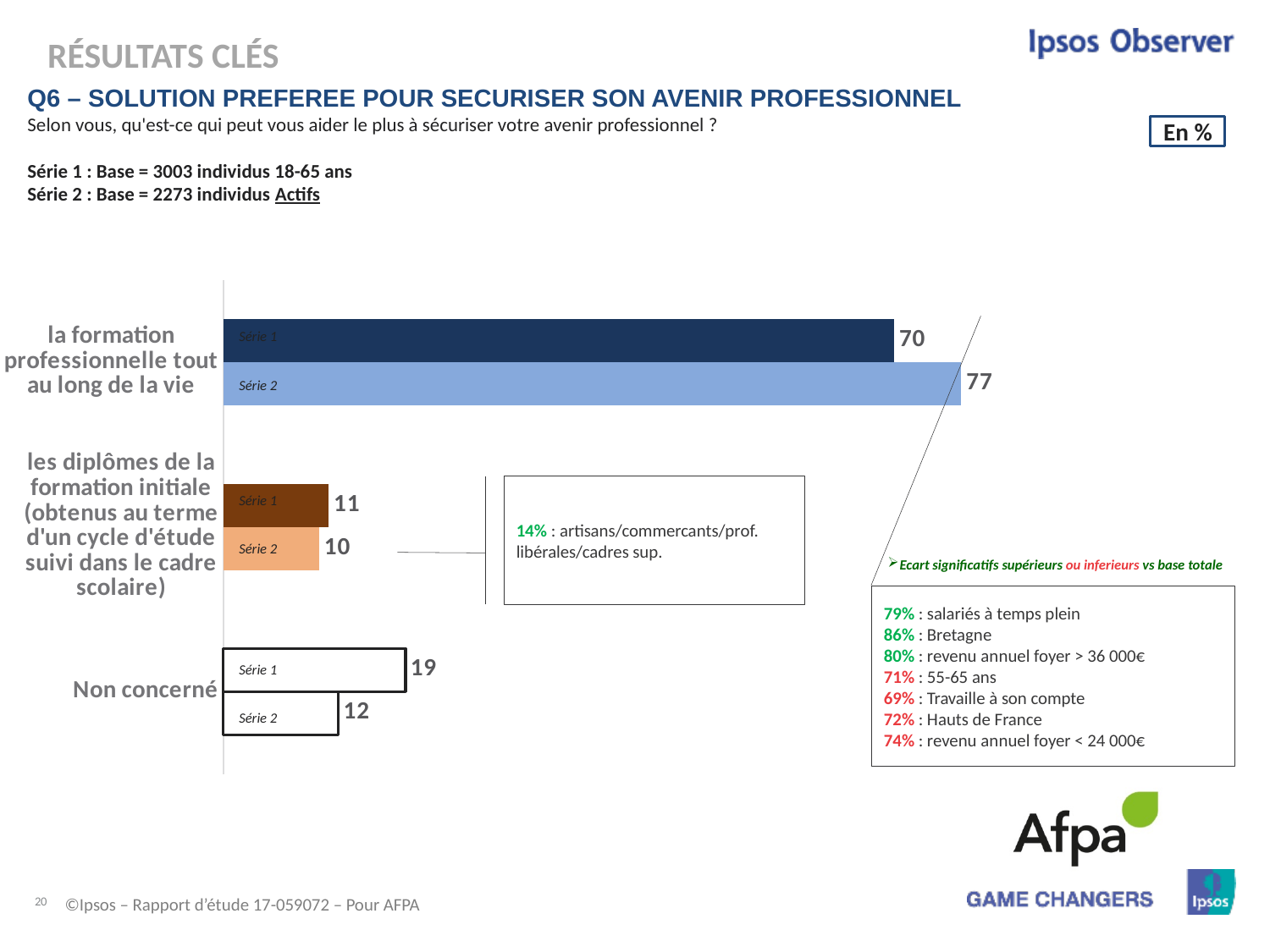
Which category has the highest Série 2 value? la formation professionnelle tout au long de la vie Which category has the lowest Série 1 value? les diplômes de la formation initiale What is the difference between the Série 2 and Série 1 values for "la formation professionnelle tout au long de la vie"? 7 What is the Série 1 value for "Non concerné"? 19 For "Non concerné", which is larger: the Série 1 value or the Série 2 value? Série 1 What is the Série 2 value for "la formation professionnelle tout au long de la vie"? 77 What is the Série 2 value for "les diplômes de la formation initiale"? 10 What type of chart is shown on the slide? bar chart How many categories are shown on the chart? 3 What is the Série 1 value for "la formation professionnelle tout au long de la vie"? 70 What is the base of Série 2 according to the slide? 2273 individus Actifs What is the difference between the Série 1 and Série 2 values for "Non concerné"? 7